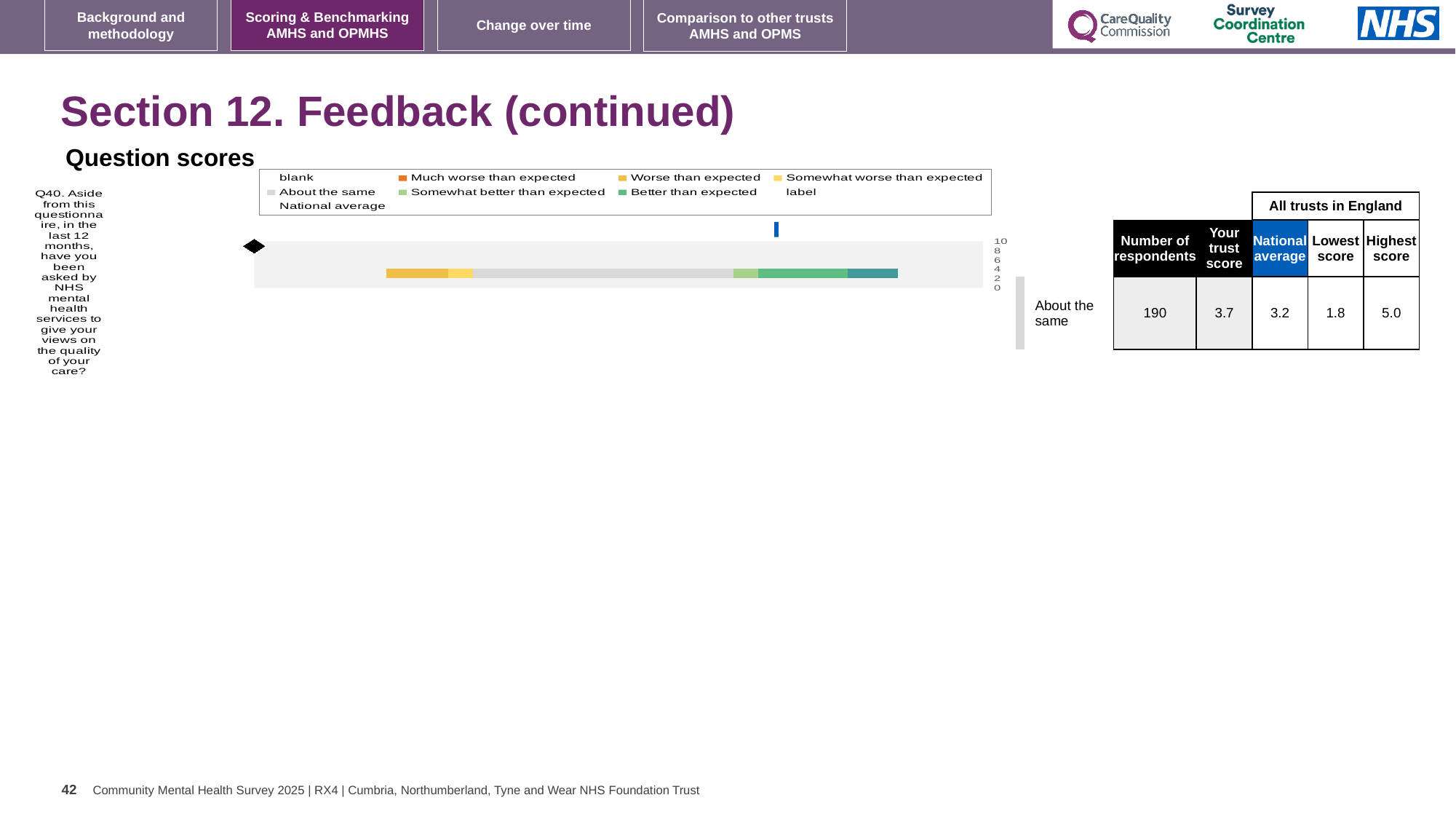
In the table beside the chart, what is your trust score for Q40? 3.7 In the table beside the chart, what is the lowest score among all trusts in England for Q40? 1.8 Which question number is plotted on the chart? Q40 In the table beside the chart, what is the number of respondents for Q40? 190 In the table beside the chart, what is the national average for Q40? 3.2 What rating label is shown to the right of the Q40 bar? About the same How many question categories are plotted on the chart? 1 What kind of chart is shown under "Question scores"? bar chart What is the difference between your trust score and the national average for Q40? 0.5 How many entries does the chart's legend list? 9 In the table beside the chart, what is the highest score among all trusts in England for Q40? 5.0 Is your trust score for Q40 larger or smaller than the national average? larger